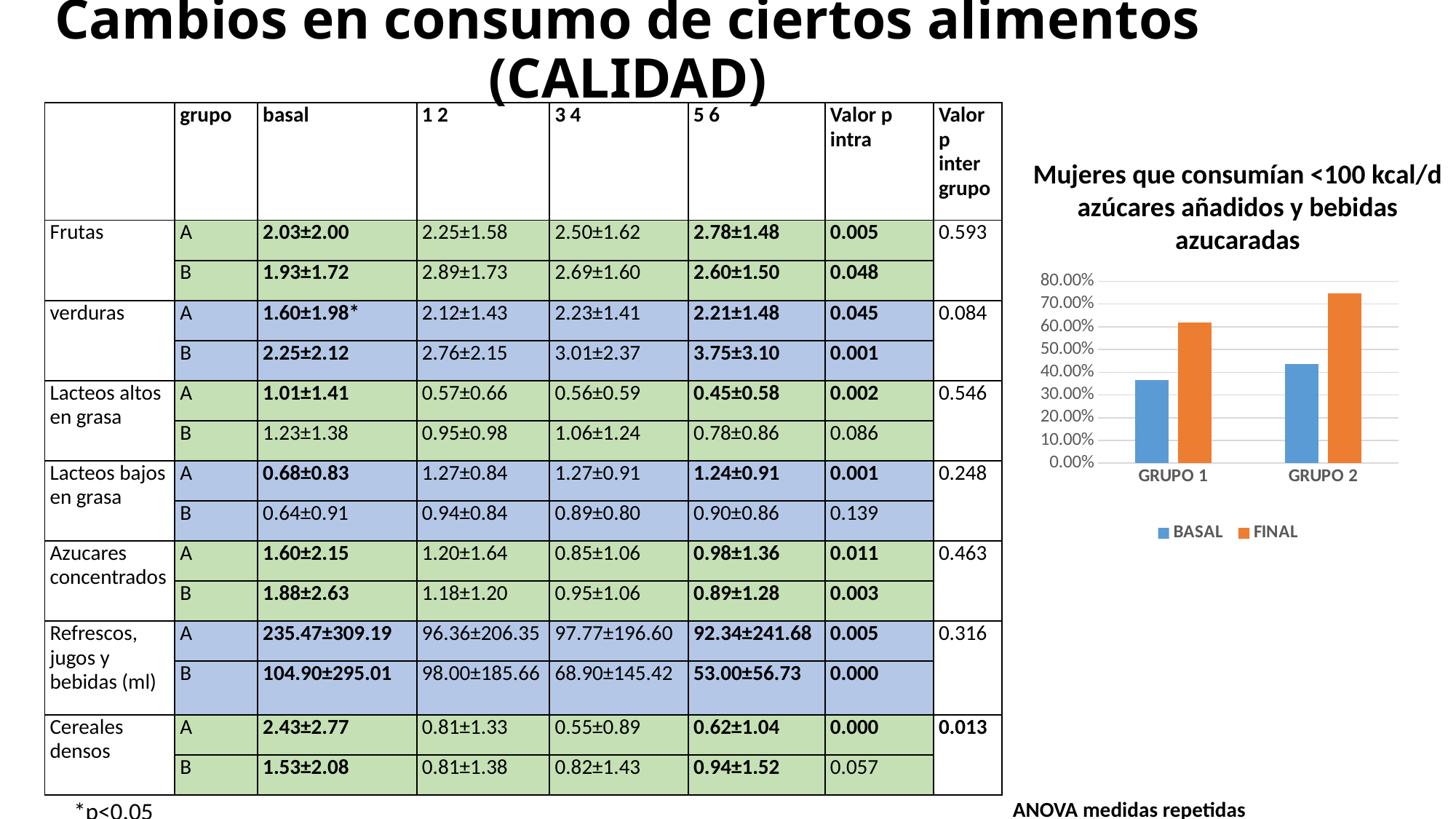
Which series and category has the tallest bar in the chart? FINAL, GRUPO 2 How many series does the chart's legend list? 2 What is the title of the chart on the slide? Mujeres que consumían <100 kcal/d azúcares añadidos y bebidas azucaradas Is the FINAL value for GRUPO 2 greater or less than 70.00%? greater Is the FINAL value for GRUPO 1 greater or less than 50.00%? greater In the chart, is the FINAL value for GRUPO 1 larger or smaller than the BASAL value for GRUPO 1? larger What kind of chart is shown on the right side of the slide? bar chart In the chart, which group has the higher BASAL value, GRUPO 1 or GRUPO 2? GRUPO 2 Which colour represents the FINAL series in the chart? orange Which series and category has the shortest bar in the chart? BASAL, GRUPO 1 How many categories are shown on the x axis of the chart? 2 Is the BASAL value for GRUPO 1 greater or less than 40.00%? less